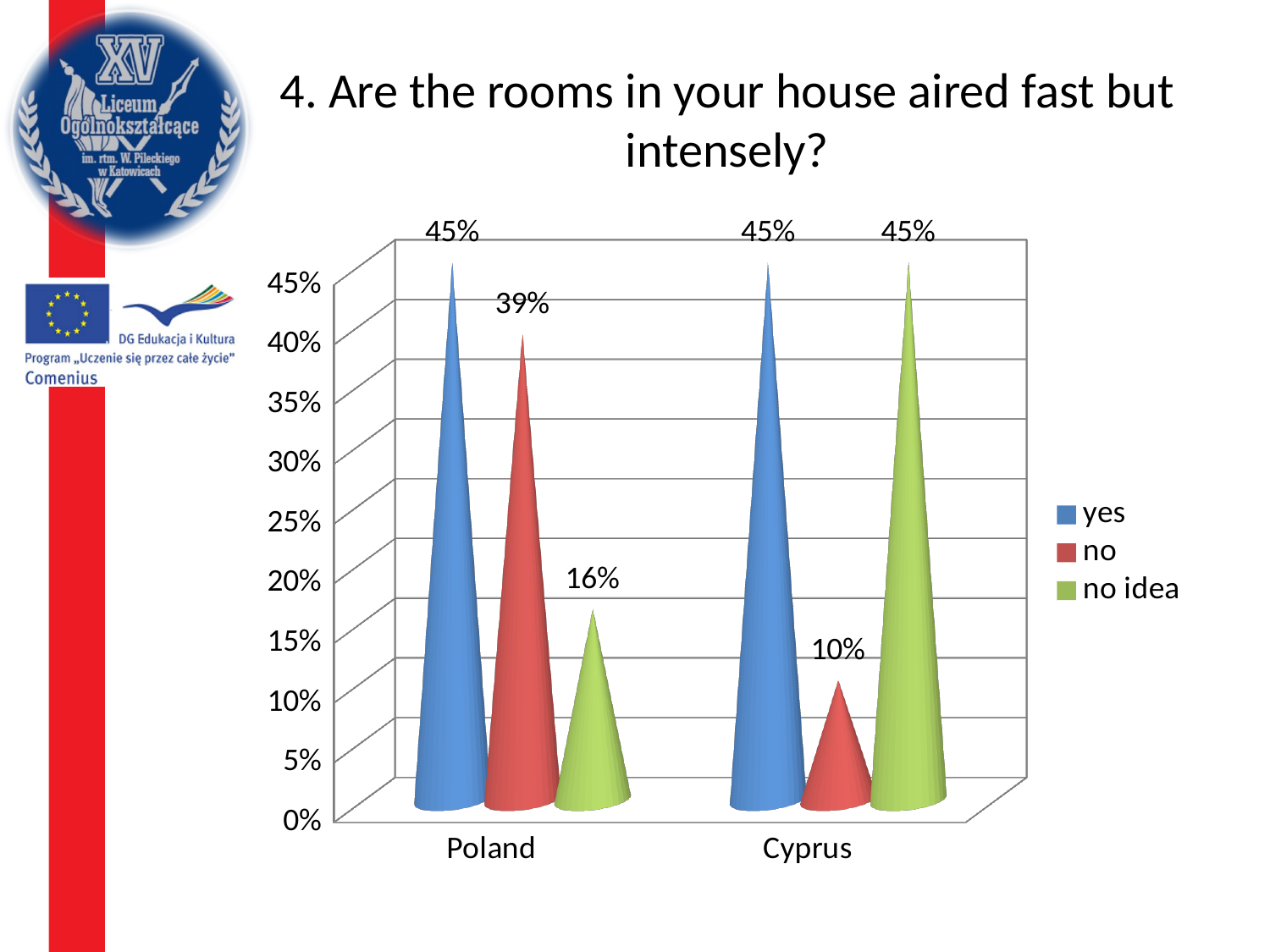
What is the value for "no idea" in Poland? 16% What percentage of respondents in Poland answered "no"? 39% What is the value for "no idea" in Cyprus? 45% What is the difference between the "no" values for Poland and Cyprus? 29% What percentage of respondents in Poland answered "yes"? 45% Which is larger: "no idea" in Poland or "no idea" in Cyprus? no idea in Cyprus How many countries are shown on the x axis? 2 What is the title of the chart? 4. Are the rooms in your house aired fast but intensely? What is the value for "no" in Cyprus? 10% How many series does the legend list? 3 Which answer has the highest value for Poland? yes Which answer has the lowest value for Cyprus? no